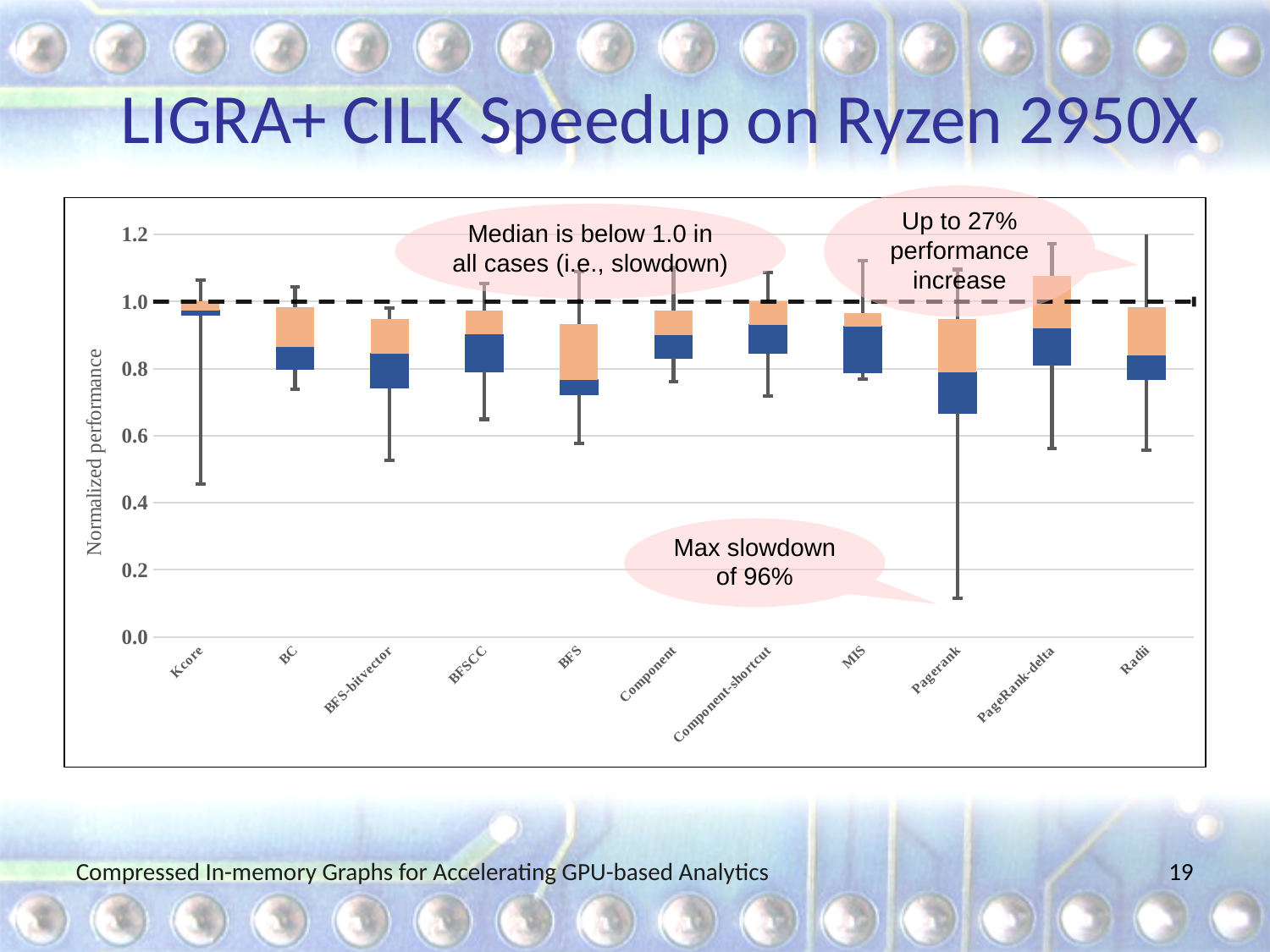
How many categories are shown along the x axis of the chart? 11 Which category has the lowest bottom whisker on the chart? Pagerank What kind of chart is shown on the slide? Box-and-whisker plot Which category's box extends highest above the 1.0 reference line? PageRank-delta Which has the lower bottom whisker, Kcore or Pagerank? Pagerank Is the bottom of the box for Pagerank greater or less than 0.6? greater Is the top whisker for PageRank-delta greater or less than 1.0? greater Is the top whisker for MIS greater or less than 1.0? greater At what value is the horizontal dashed reference line drawn on the chart? 1.0 What is the label of the y axis of the chart? Normalized performance